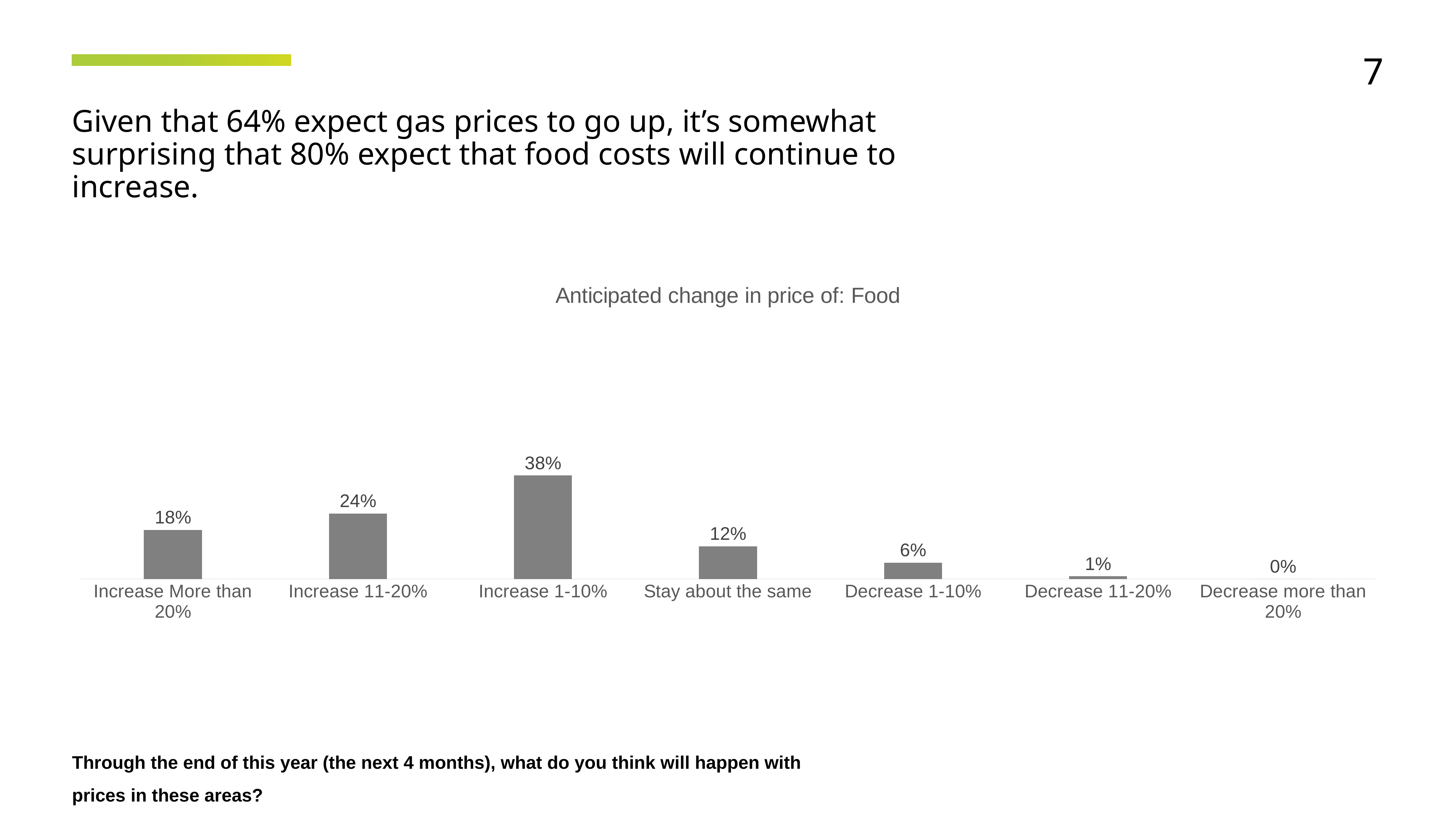
What is the difference between the values for Increase 1-10% and Increase 11-20%? 14% What is the value for Increase 1-10%? 38% What kind of chart is shown on the slide? Bar chart Do the values rise or fall from Increase 1-10% to Decrease more than 20%? Fall How many categories are shown on the x axis? 7 What is the title of the chart? Anticipated change in price of: Food What is the value for Stay about the same? 12% Which is larger, the value for Increase More than 20% or the value for Stay about the same? Increase More than 20% What is the value for Increase More than 20%? 18% What is the value for Decrease 11-20%? 1% Which category has the lowest value? Decrease more than 20% Which category has the highest value? Increase 1-10%